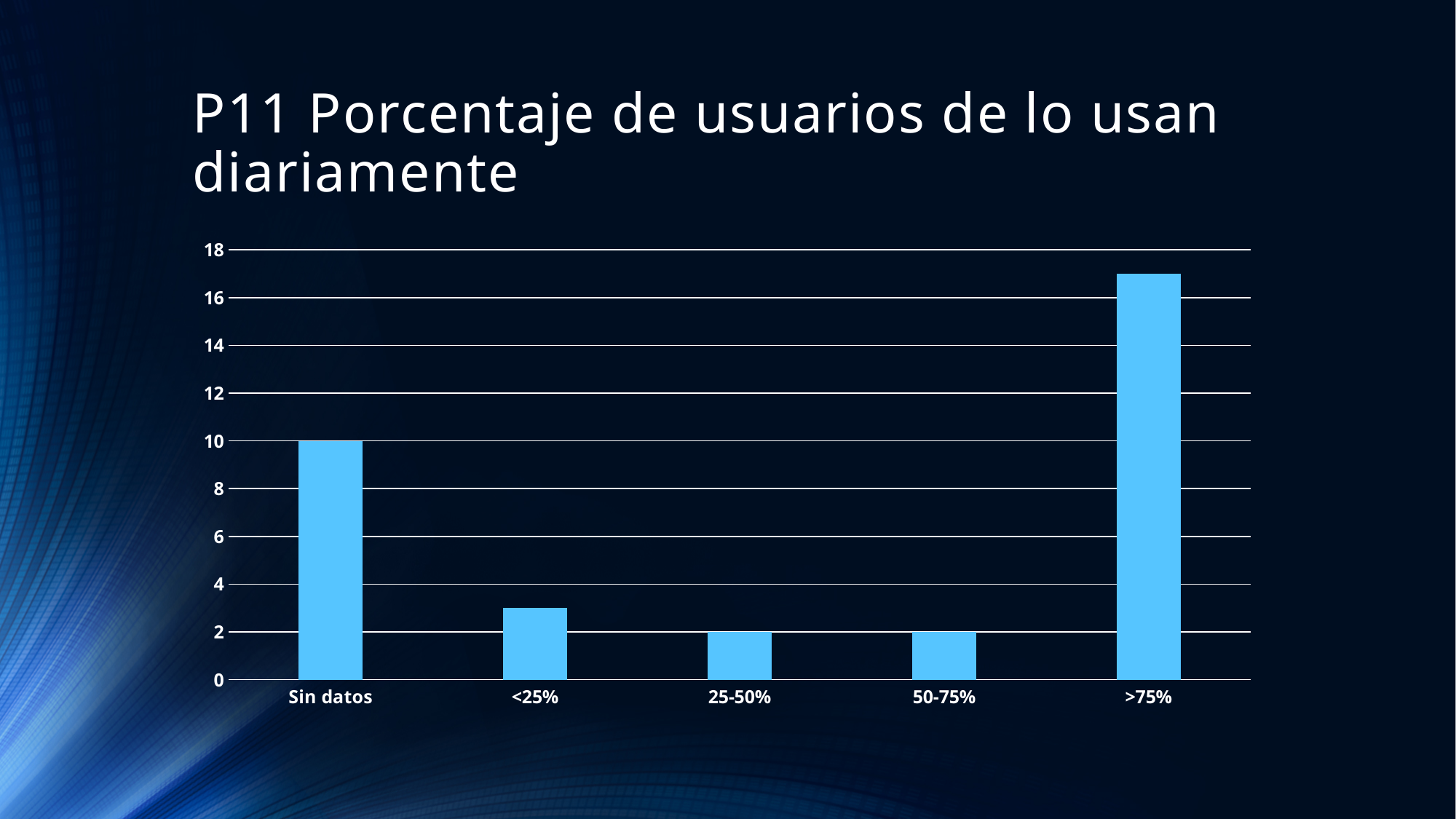
Which is larger, the value for 'Sin datos' or the value for '<25%'? Sin datos Is the value for '>75%' greater or less than 16? greater Is the value for '<25%' greater or less than 4? less What kind of chart is shown on the slide? bar chart What is the value for the 'Sin datos' category? 10 How many categories are shown on the x axis? 5 What is the value for the '25-50%' category? 2 Which category has the highest value? >75% What is the difference between the value for 'Sin datos' and the value for '25-50%'? 8 What is the value for the '50-75%' category? 2 What is the title of the slide containing the chart? P11 Porcentaje de usuarios de lo usan diariamente Is the value for '<25%' greater or less than 2? greater